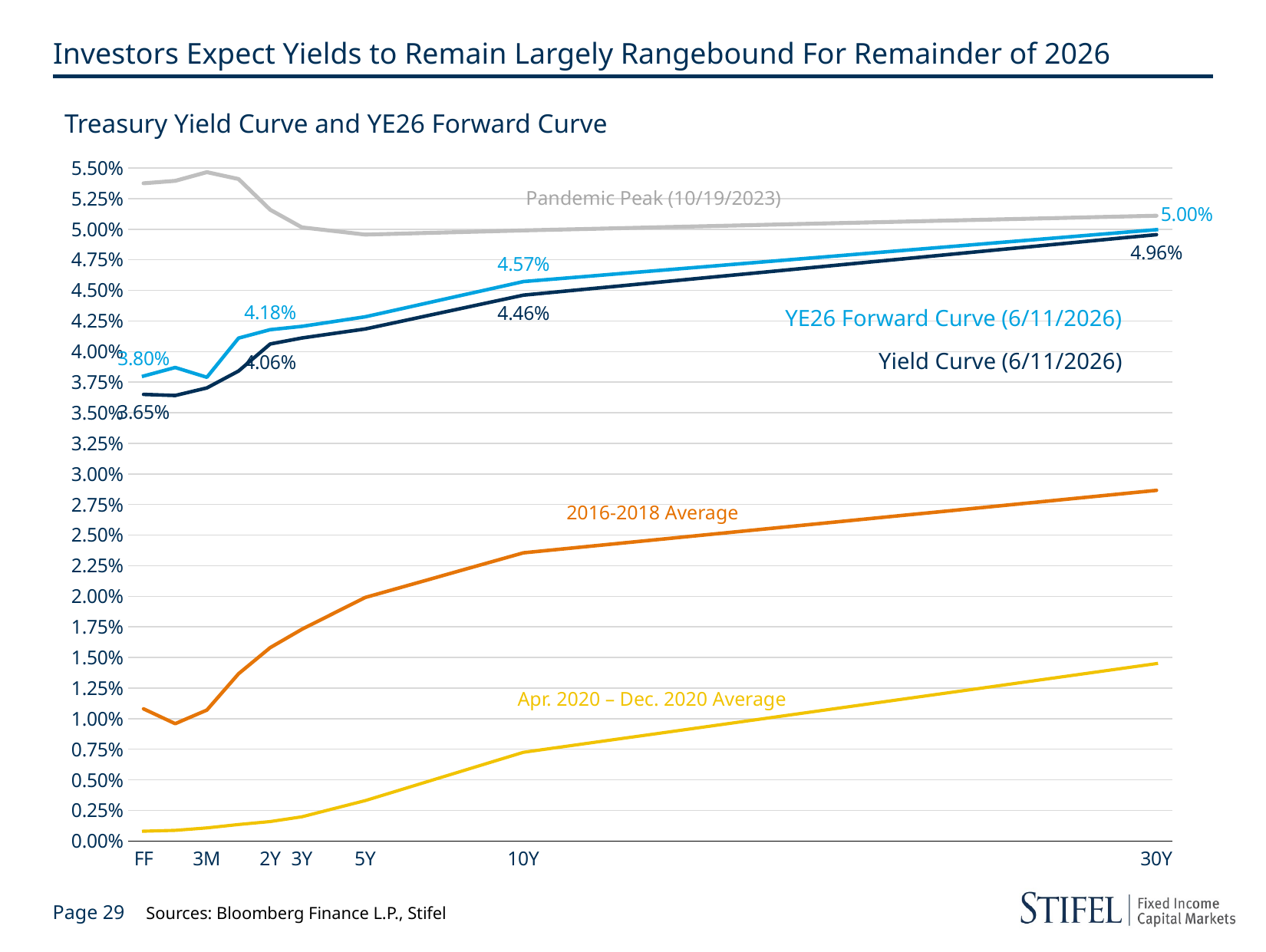
Which series has the lowest values across the chart? Apr. 2020 – Dec. 2020 Average What is the value of the Yield Curve (6/11/2026) at 30Y? 4.96% Is the 2016-2018 Average at 30Y greater or less than 3.00%? less What is the difference between the YE26 Forward Curve value at 30Y and its value at FF? 1.20% What type of chart is shown on the slide? line chart What is the difference between the YE26 Forward Curve and the Yield Curve at 10Y? 0.11% What is the value of the Yield Curve (6/11/2026) at 10Y? 4.46% What is the value of the YE26 Forward Curve (6/11/2026) at 30Y? 5.00% What is the title of the chart? Treasury Yield Curve and YE26 Forward Curve Does the Apr. 2020 – Dec. 2020 Average rise or fall from FF to 30Y? rise What is the value of the YE26 Forward Curve (6/11/2026) at 10Y? 4.57% What is the value of the Yield Curve (6/11/2026) at FF? 3.65%